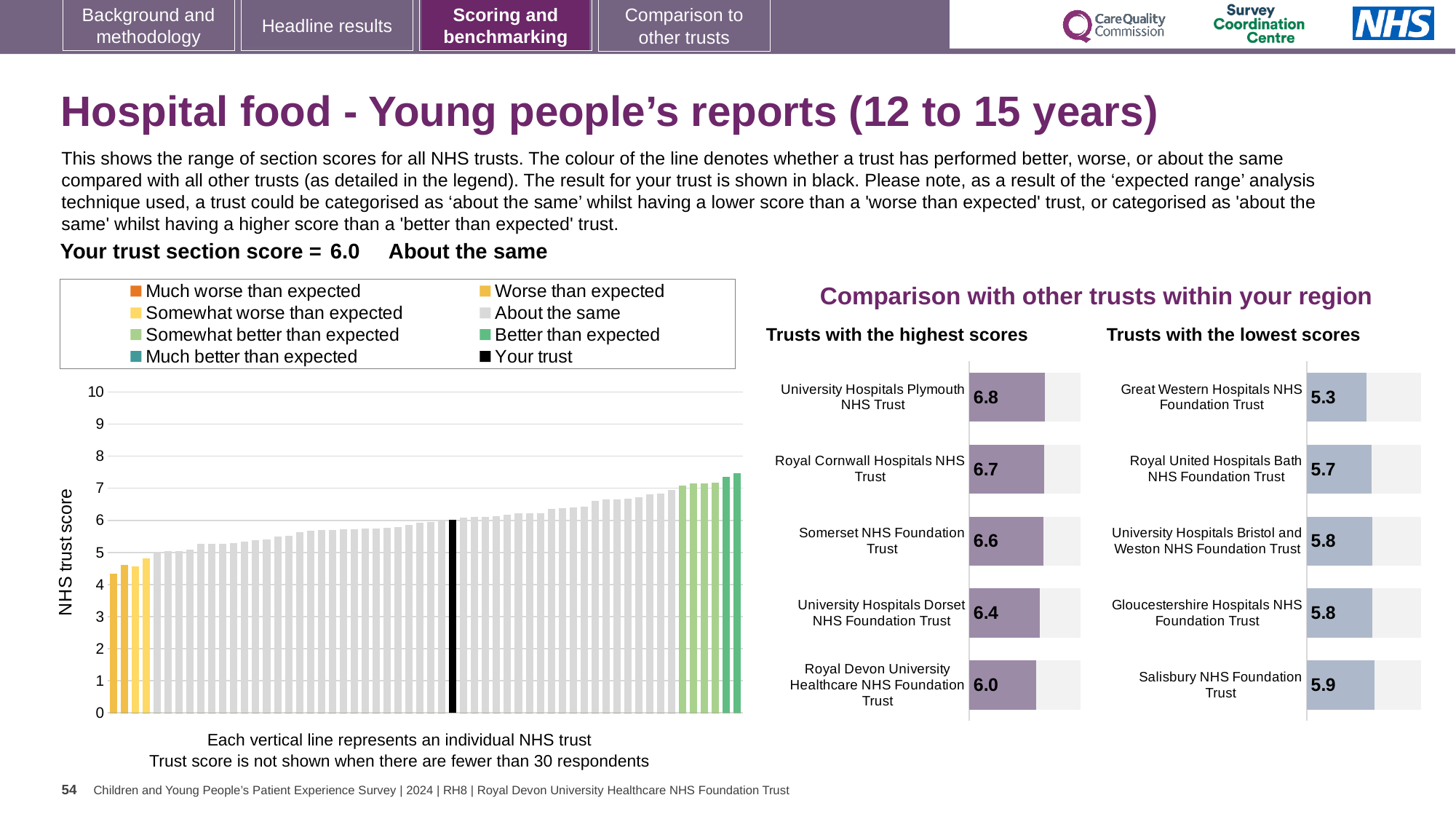
In the 'Trusts with the lowest scores' chart, what is the difference between the scores of Salisbury NHS Foundation Trust and Great Western Hospitals NHS Foundation Trust? 0.6 In the 'Trusts with the lowest scores' chart, which trust has the lowest score? Great Western Hospitals NHS Foundation Trust What kind of chart is the 'NHS trust score' chart on the left? bar chart In the 'NHS trust score' chart on the left, do the trust scores rise or fall from left to right? rise In the 'Trusts with the highest scores' chart, what is the difference between the scores of University Hospitals Plymouth NHS Trust and Royal Devon University Healthcare NHS Foundation Trust? 0.8 How many trusts are shown in the 'Trusts with the lowest scores' chart? 5 In the 'Trusts with the highest scores' chart, which trust has the highest score? University Hospitals Plymouth NHS Trust In the 'NHS trust score' chart on the left, what colour is used for the bar representing 'Your trust'? black How many entries does the legend of the 'NHS trust score' chart on the left list? 8 In the 'Trusts with the highest scores' chart, which has the larger score: Royal Cornwall Hospitals NHS Trust or University Hospitals Dorset NHS Foundation Trust? Royal Cornwall Hospitals NHS Trust In the 'Trusts with the highest scores' chart, what is the score for Somerset NHS Foundation Trust? 6.6 In the 'Trusts with the lowest scores' chart, what is the score for Salisbury NHS Foundation Trust? 5.9